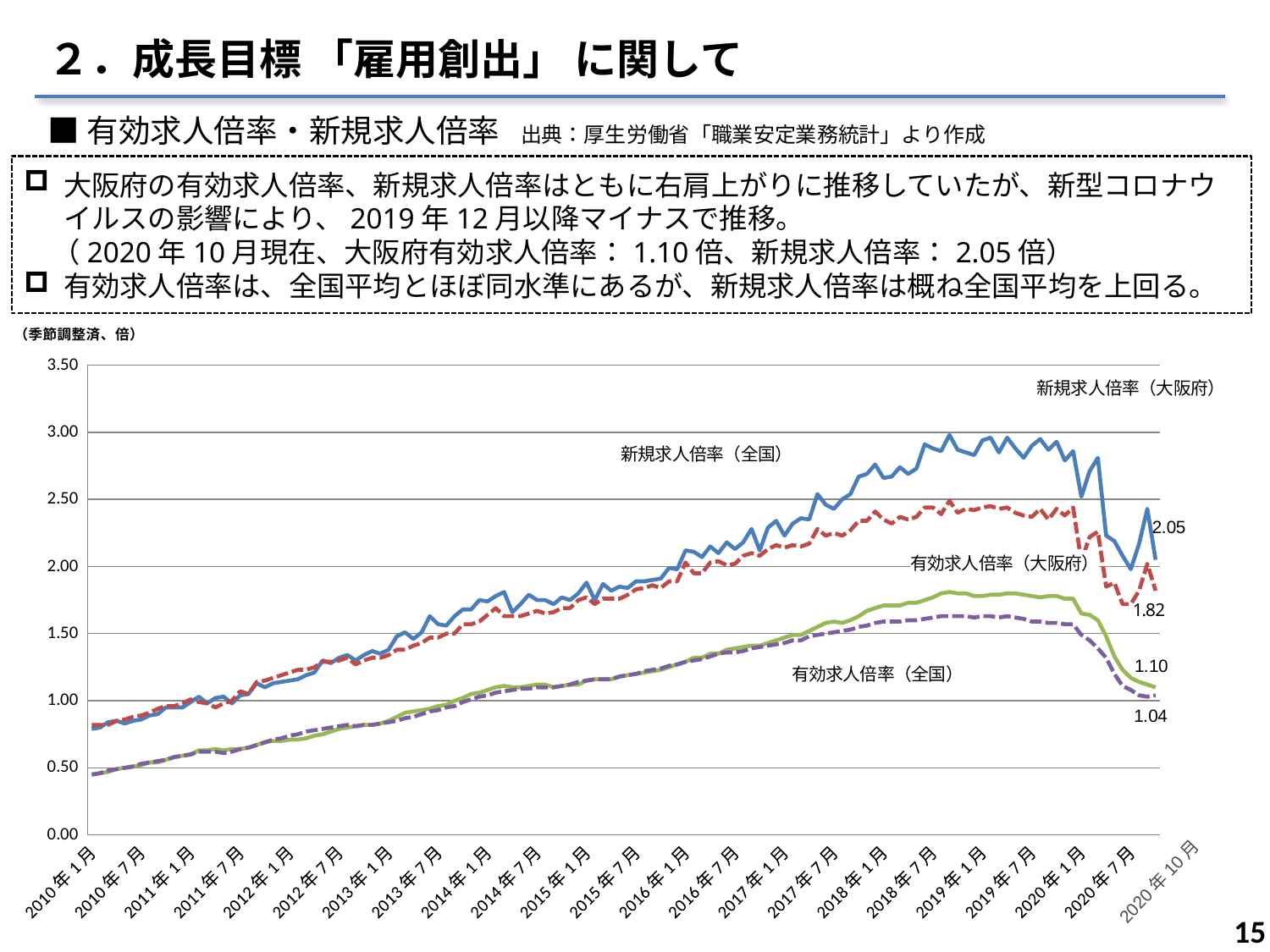
What is the value of 新規求人倍率（大阪府） at 2020年10月? 2.05 What is the unit label shown above the chart's y axis? （季節調整済、倍） Which series has the lowest value at 2020年10月? 有効求人倍率（全国） What type of chart is shown on the slide? line chart What is the difference between 有効求人倍率（大阪府） and 有効求人倍率（全国） at 2020年10月? 0.06 What is the value of 新規求人倍率（全国） at 2020年10月? 1.82 How many series are plotted on the chart? 4 Is the value of 新規求人倍率（大阪府） at 2010年1月 greater or less than 1.00? less What is the value of 有効求人倍率（全国） at 2020年10月? 1.04 Which series has the highest value at 2020年10月? 新規求人倍率（大阪府） What is the difference between 新規求人倍率（大阪府） and 新規求人倍率（全国） at 2020年10月? 0.23 What is the value of 有効求人倍率（大阪府） at 2020年10月? 1.10